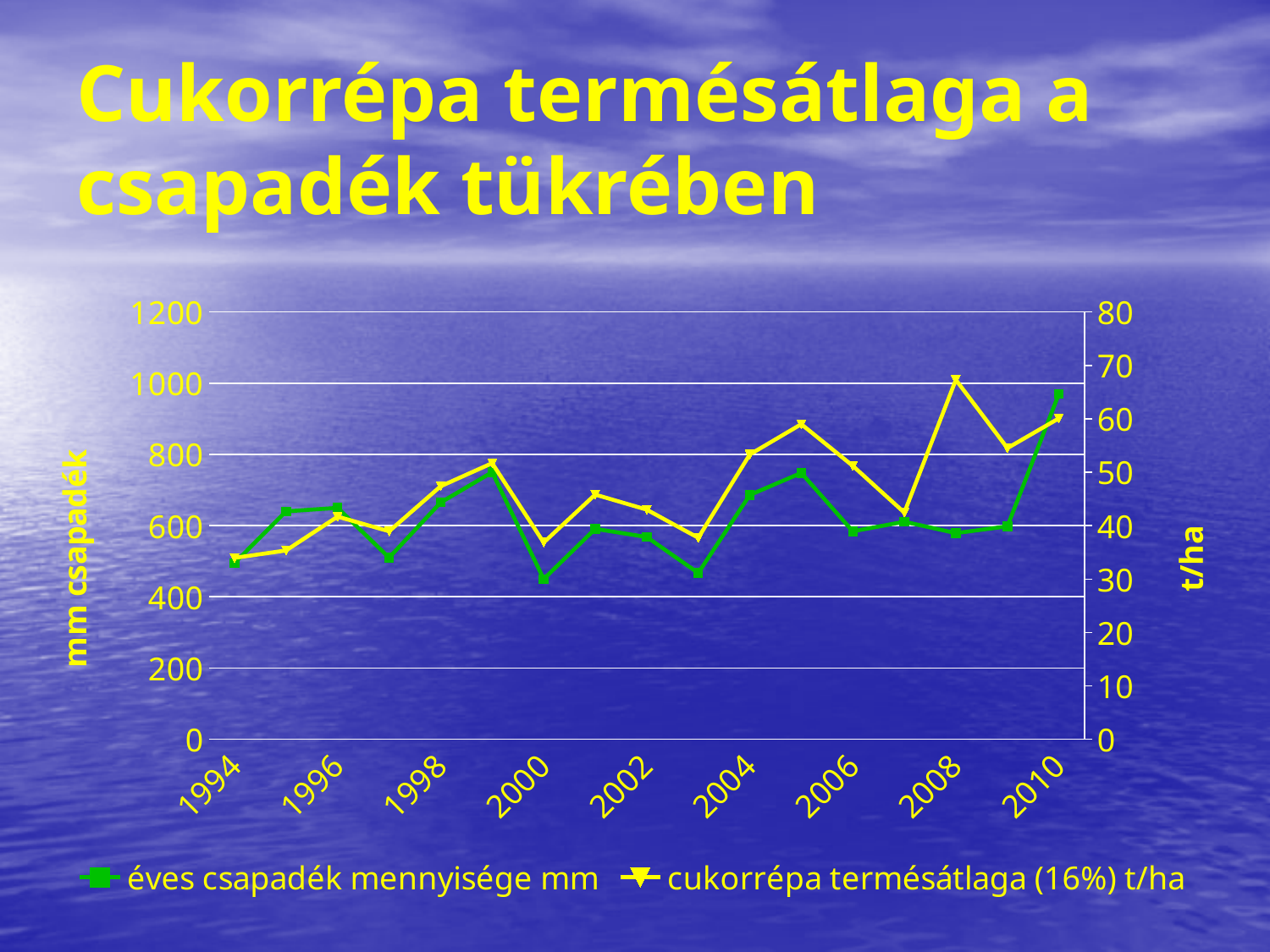
Is the sugar beet yield value for 2008 greater or less than 60? greater Is the annual precipitation value for 2010 greater or less than 800? greater Which year has the larger sugar beet yield, 2003 or 2005? 2005 Is the sugar beet yield value for 1994 greater or less than 40? less Which series is drawn in green? éves csapadék mennyisége mm How many series does the legend list? 2 What kind of chart is shown on the slide? line chart Does the annual precipitation rise or fall from 2009 to 2010? rise What is the label of the right-hand vertical axis? t/ha In which year is the annual precipitation (éves csapadék mennyisége mm) highest? 2010 In which year is the sugar beet yield (cukorrépa termésátlaga) highest? 2008